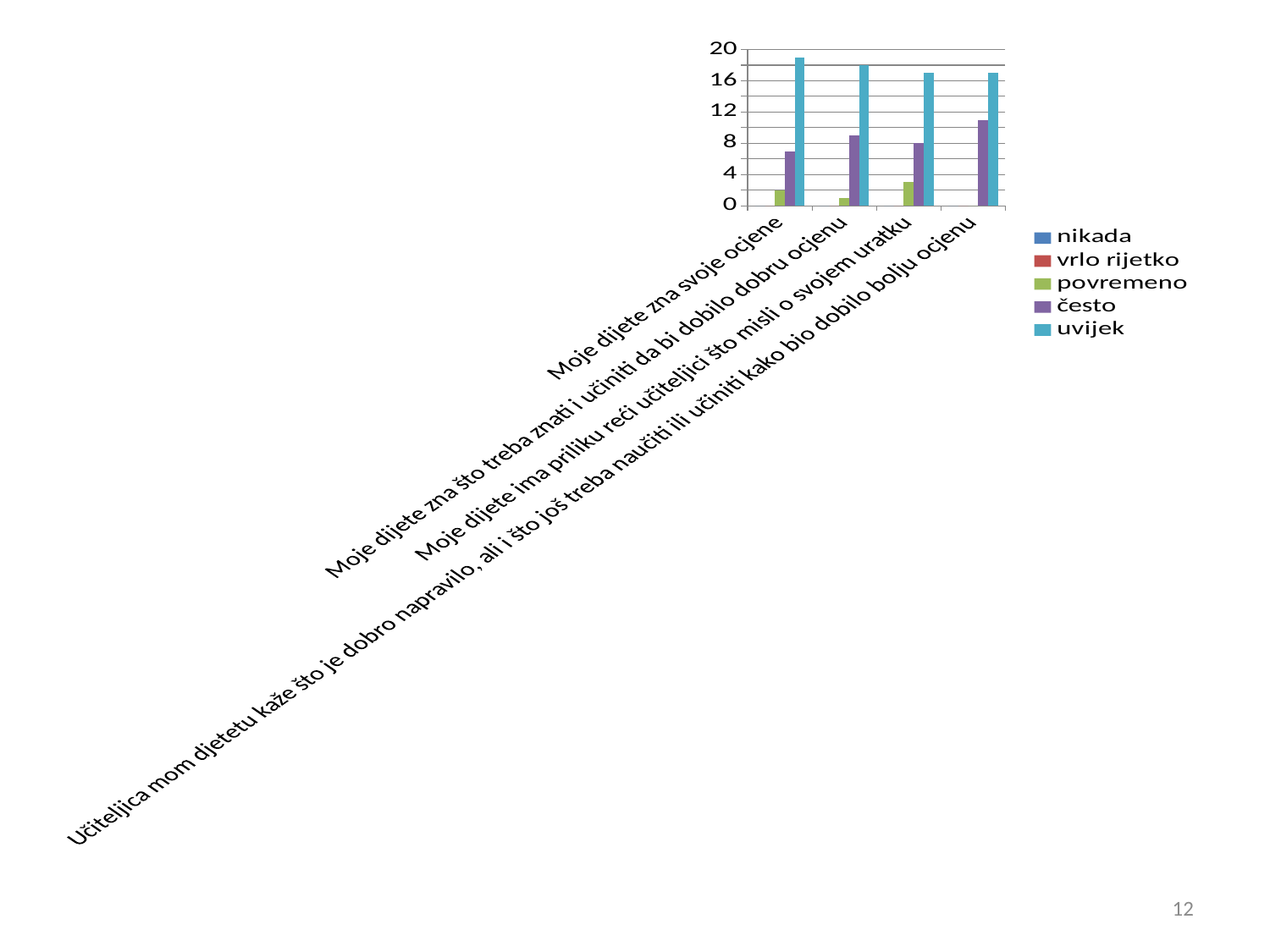
For 'Moje dijete zna svoje ocjene', which is larger: 'često' or 'uvijek'? uvijek Which series is listed last in the legend? uvijek How many series does the legend list? 5 Is the value of 'često' for 'Učiteljica mom djetetu kaže što je dobro napravilo, ali i što još treba naučiti ili učiniti kako bio dobilo bolju ocjenu' greater or less than 8? greater Which category has the highest value for the 'često' series? Učiteljica mom djetetu kaže što je dobro napravilo, ali i što još treba naučiti ili učiniti kako bio dobilo bolju ocjenu Is the value of 'povremeno' for 'Moje dijete ima priliku reći učiteljici što misli o svojem uratku' greater or less than 4? less Which series is listed first in the legend? nikada Is the value of 'uvijek' for 'Moje dijete zna svoje ocjene' greater or less than 16? greater How many categories are shown on the x axis? 4 What kind of chart is shown on the slide? bar chart For 'Moje dijete ima priliku reći učiteljici što misli o svojem uratku', which is larger: 'povremeno' or 'često'? često